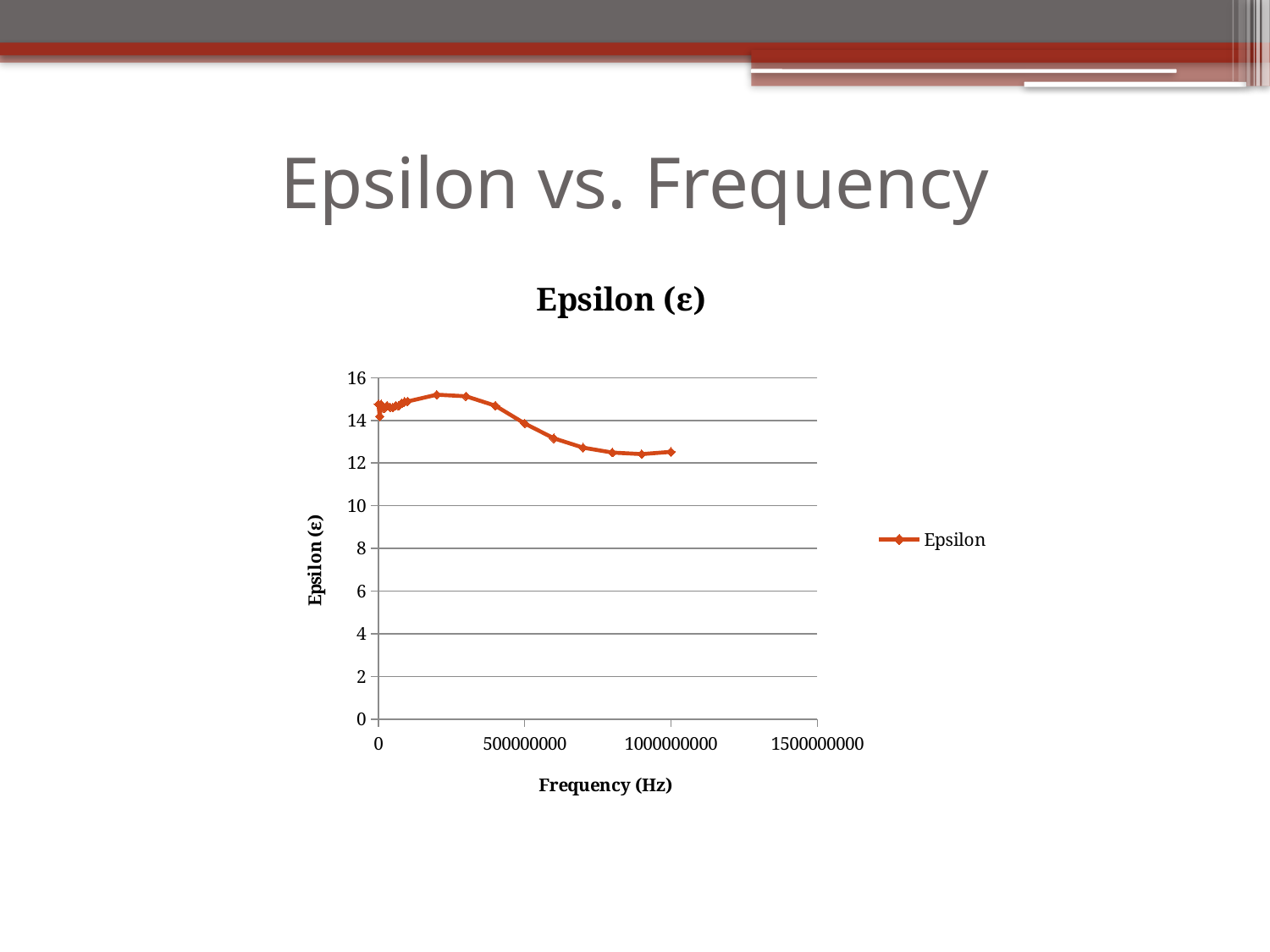
What is the label on the x axis of the chart? Frequency (Hz) Is the value for Epsilon at 1000000000 Hz greater or less than 12? greater Is the lowest Epsilon value on the chart greater or less than 10? greater Is the value for Epsilon at 1000000000 Hz greater or less than 14? less Between 500000000 Hz and 800000000 Hz, do the Epsilon values rise or fall? fall What is the title of the chart? Epsilon (ε) Which is larger, the Epsilon value at 200000000 Hz or at 1000000000 Hz? 200000000 Hz How many series does the legend list? 1 What kind of chart is shown on the slide? line chart